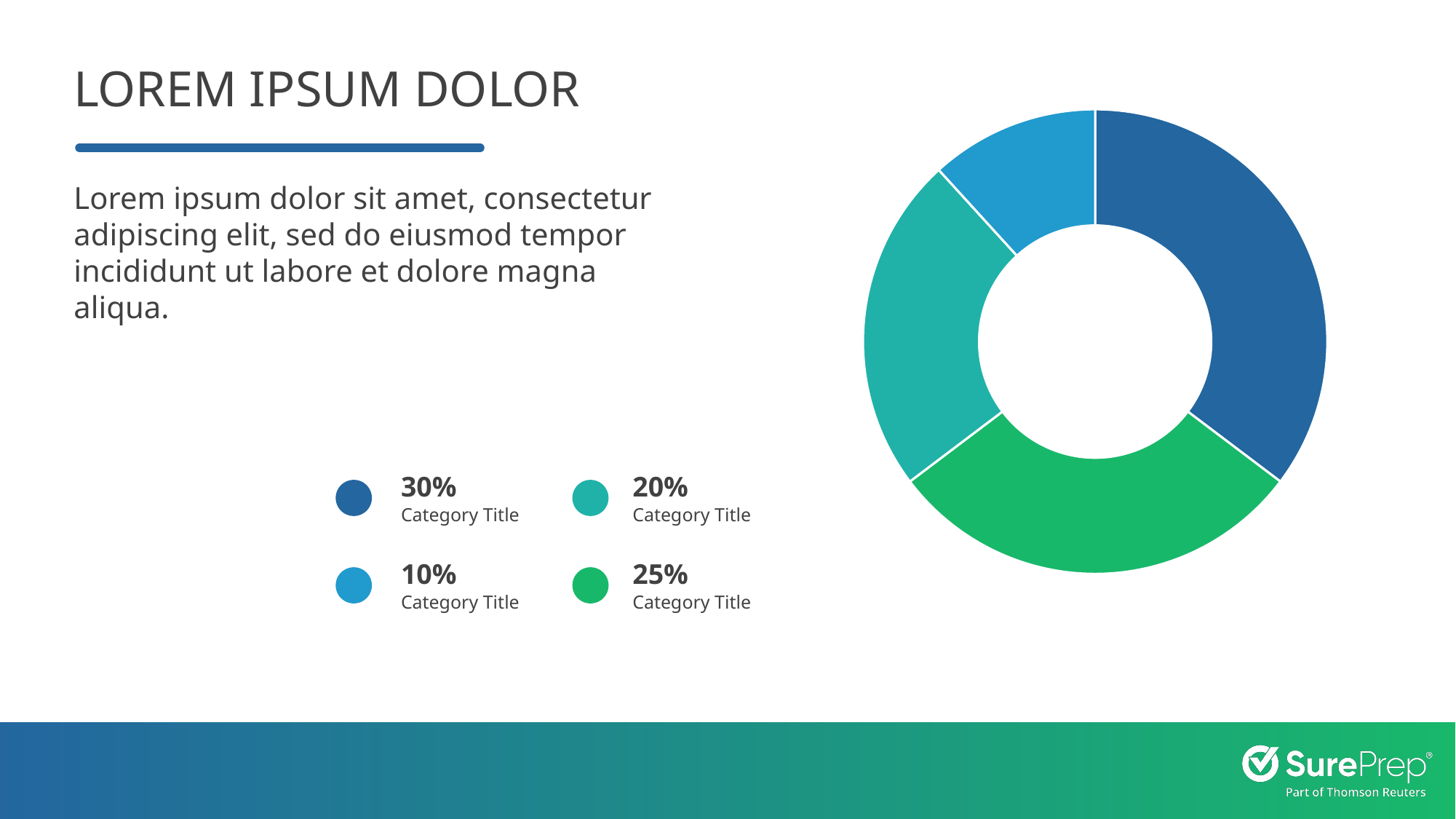
What percentage is shown for the teal slice of the donut chart? 20% Which colour slice of the donut chart has the smallest percentage? Light blue What is the difference between the dark blue slice's percentage and the green slice's percentage? 5% Which colour slice of the donut chart has the largest percentage? Dark blue What percentage is shown for the dark blue slice of the donut chart? 30% What is the difference between the teal slice's percentage and the light blue slice's percentage? 10% What percentage is shown for the green slice of the donut chart? 25% Which is larger, the teal slice or the green slice? Green slice How many slices does the donut chart have? 4 What percentage is shown for the light blue slice of the donut chart? 10% How many entries does the legend below the text list? 4 What kind of chart is shown on the slide? Donut chart